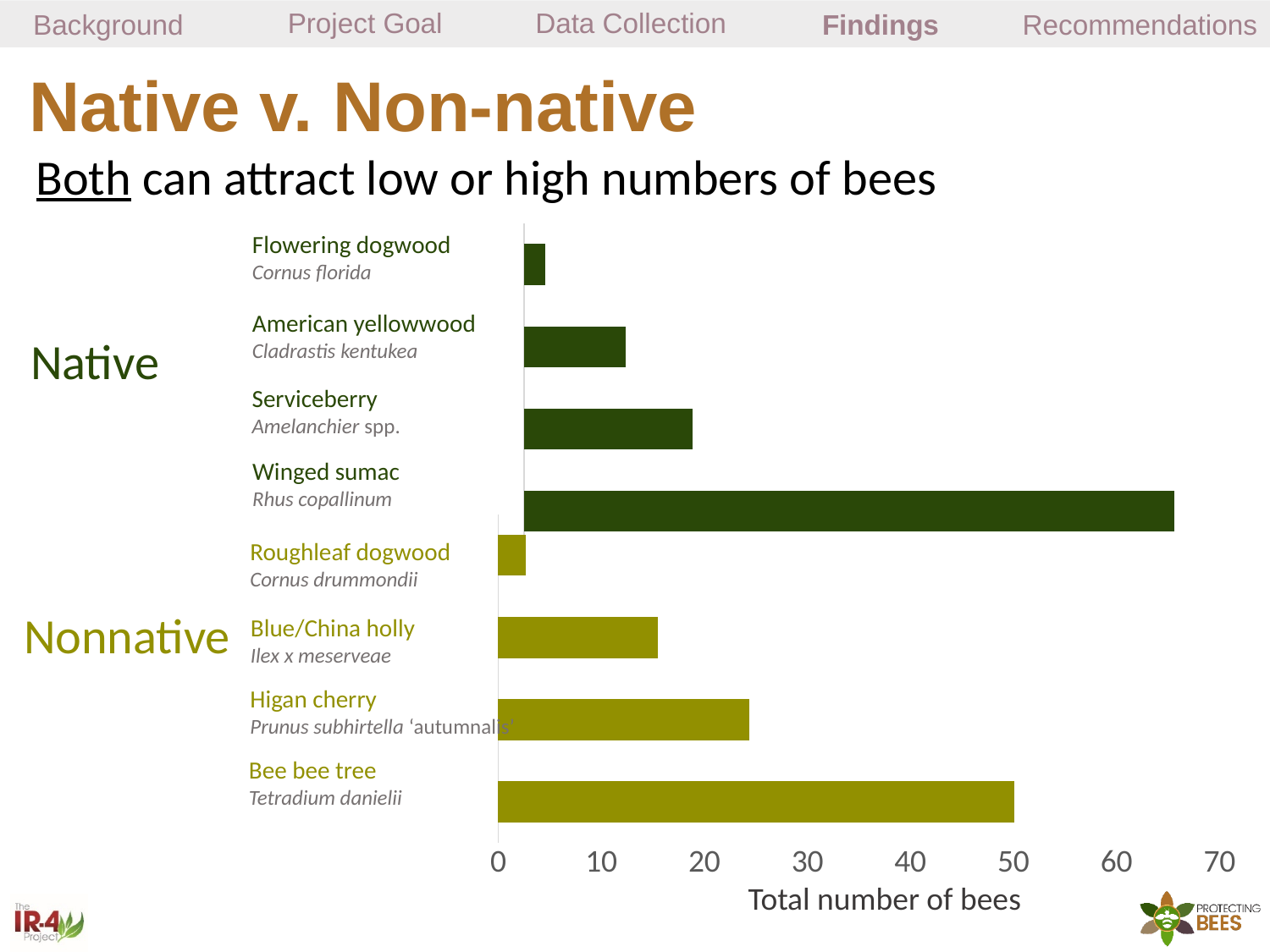
What kind of chart is shown on the slide? bar chart How many tree species are plotted in the chart? 8 Which tree species has the highest total number of bees? Winged sumac Is the value for Flowering dogwood greater or less than 10? less What is the label of the x axis? Total number of bees Is the value for Winged sumac greater or less than 60? greater Which attracts more bees, Higan cherry or Serviceberry? Higan cherry Is the value for Higan cherry greater or less than 20? greater How many of the plotted species are grouped as Native? 4 Which attracts more bees, Winged sumac or Bee bee tree? Winged sumac